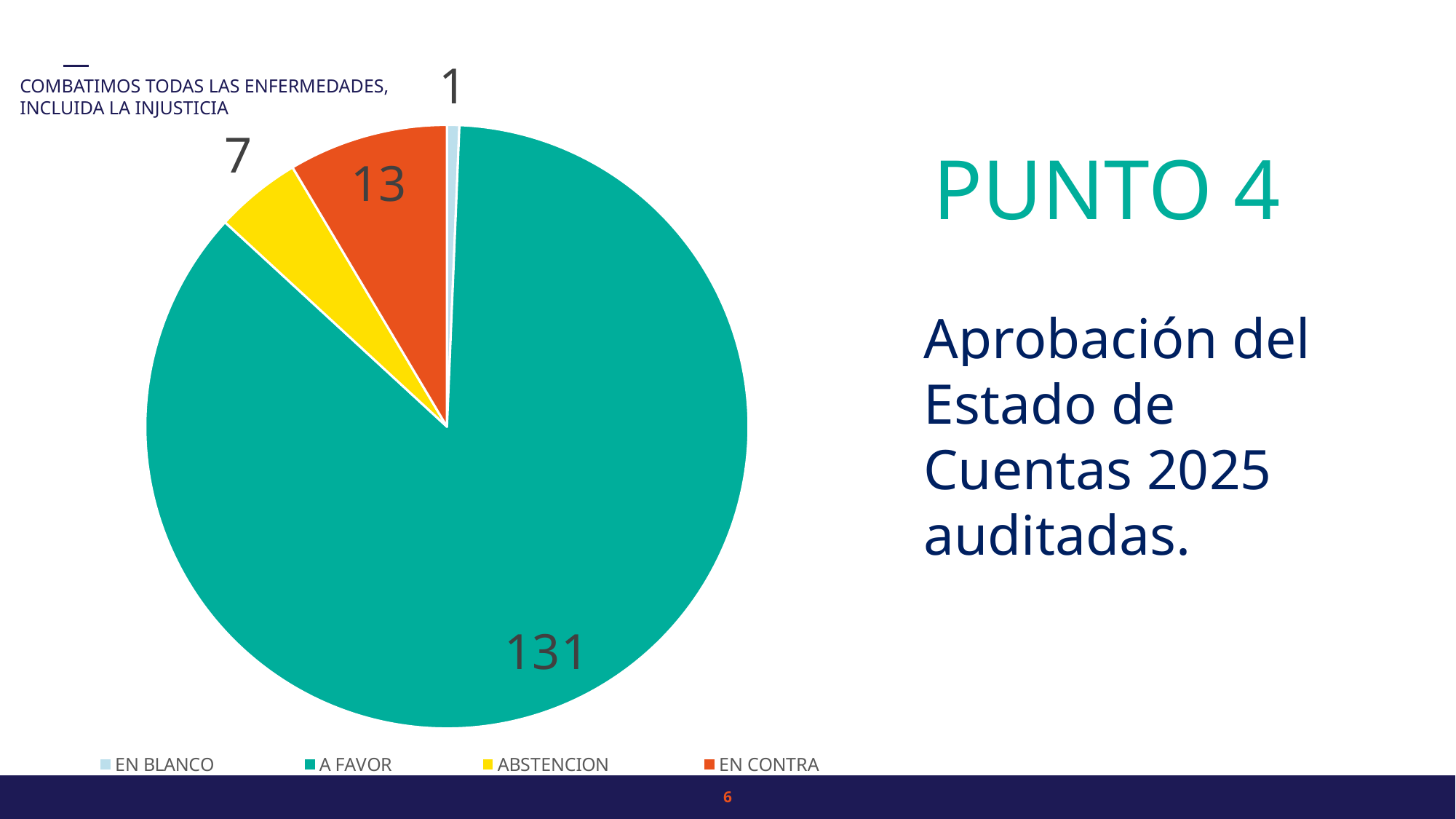
How many votes are shown for EN BLANCO? 1 What colour is the A FAVOR slice? Teal (green) Which category has the largest slice of the pie? A FAVOR Which is larger, EN CONTRA or ABSTENCION? EN CONTRA What is the difference between the A FAVOR and EN CONTRA values? 118 Which category has the smallest slice of the pie? EN BLANCO How many votes are shown for EN CONTRA? 13 How many votes are shown for A FAVOR? 131 What is the total of all the values in the pie chart? 152 What kind of chart is shown on the slide? Pie chart How many votes are shown for ABSTENCION? 7 How many categories does the pie chart have? 4